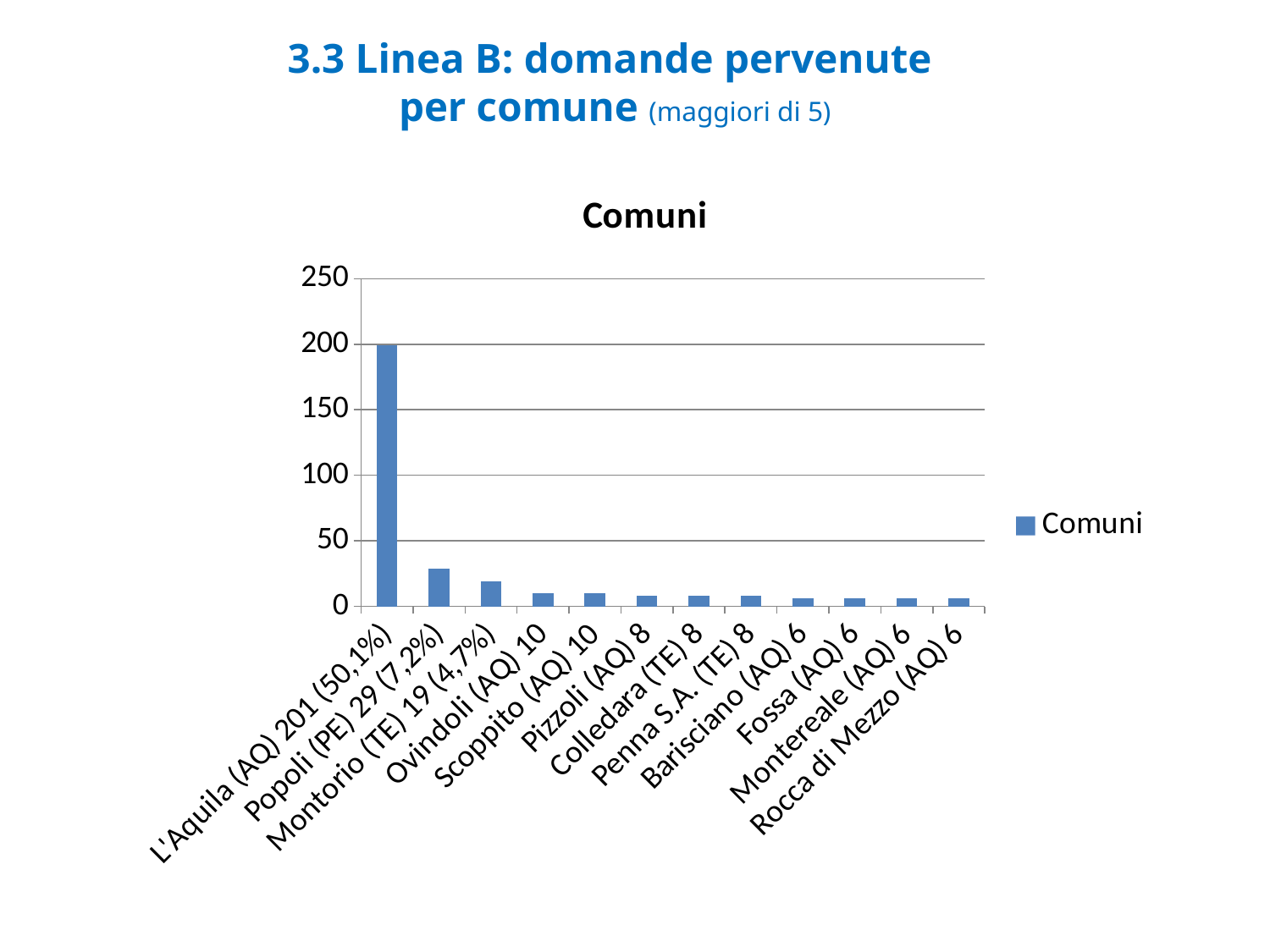
How many series does the legend list? 1 Is the value for L'Aquila (AQ) greater or less than 150? greater What is the title of the chart? Comuni What type of chart is shown on the slide? bar chart According to the category label, how many domande were received from L'Aquila (AQ)? 201 What is the difference between the values for Popoli (PE) and Montorio (TE)? 10 What percentage share is shown in the label for Montorio (TE)? 4,7% According to the category label, how many domande were received from Popoli (PE)? 29 How many comuni (categories) are plotted in the chart? 12 Do the values rise or fall moving from left to right along the x axis? fall Which comune has the highest number of domande? L'Aquila (AQ) Which is larger, the value for Ovindoli (AQ) or the value for Pizzoli (AQ)? Ovindoli (AQ)